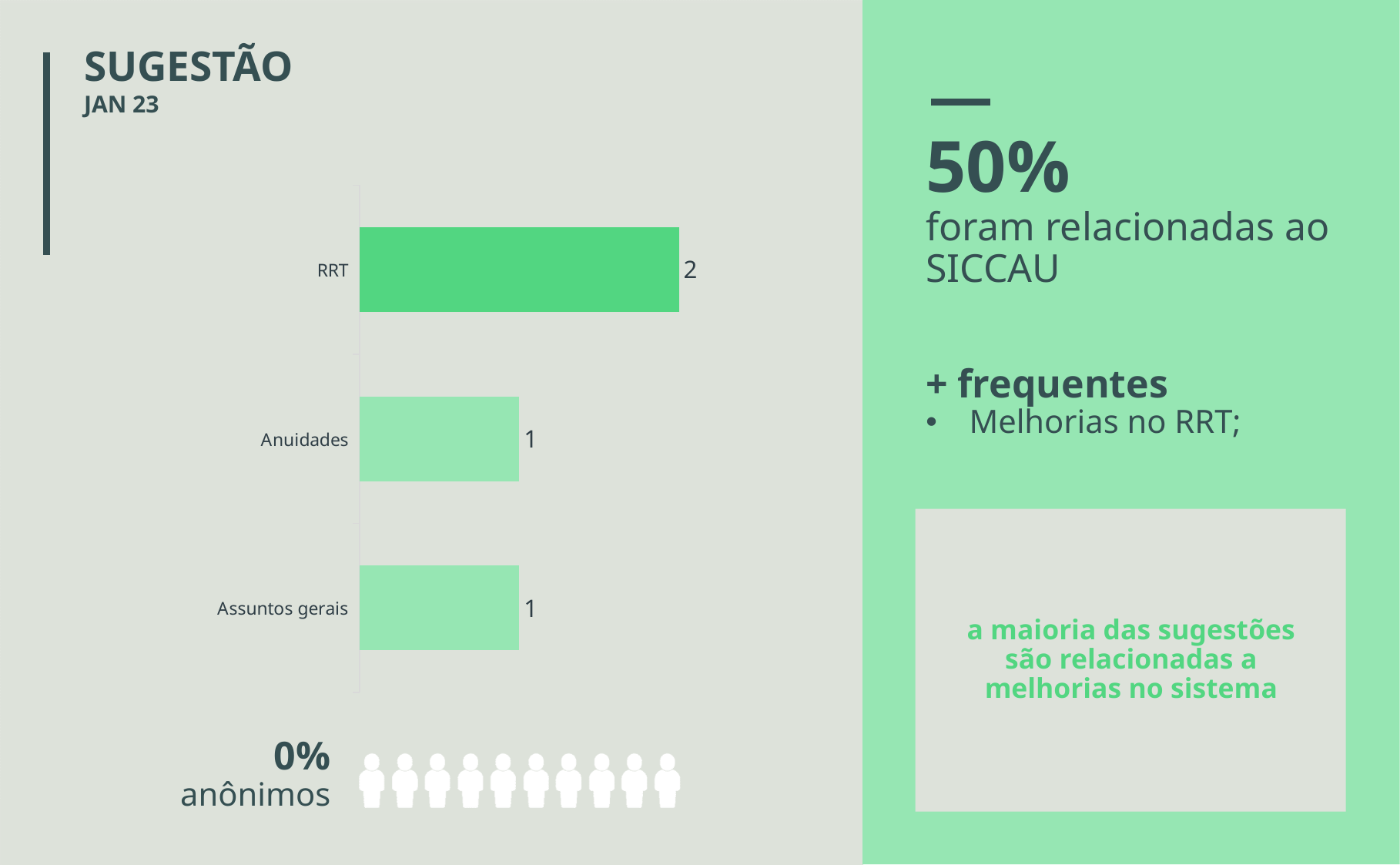
What is the value for RRT? 2 What is the value for Assuntos gerais? 1 What is the difference between the values for RRT and Anuidades? 1 Which category has the highest value? RRT What kind of chart is shown on the slide? bar chart What is the value for Anuidades? 1 How many categories are shown in the chart? 3 Which category's bar is shown in a darker green than the others? RRT What is the title shown above the chart? SUGESTÃO What is the total of the values for all three categories? 4 Which is larger, the value for RRT or the value for Assuntos gerais? RRT